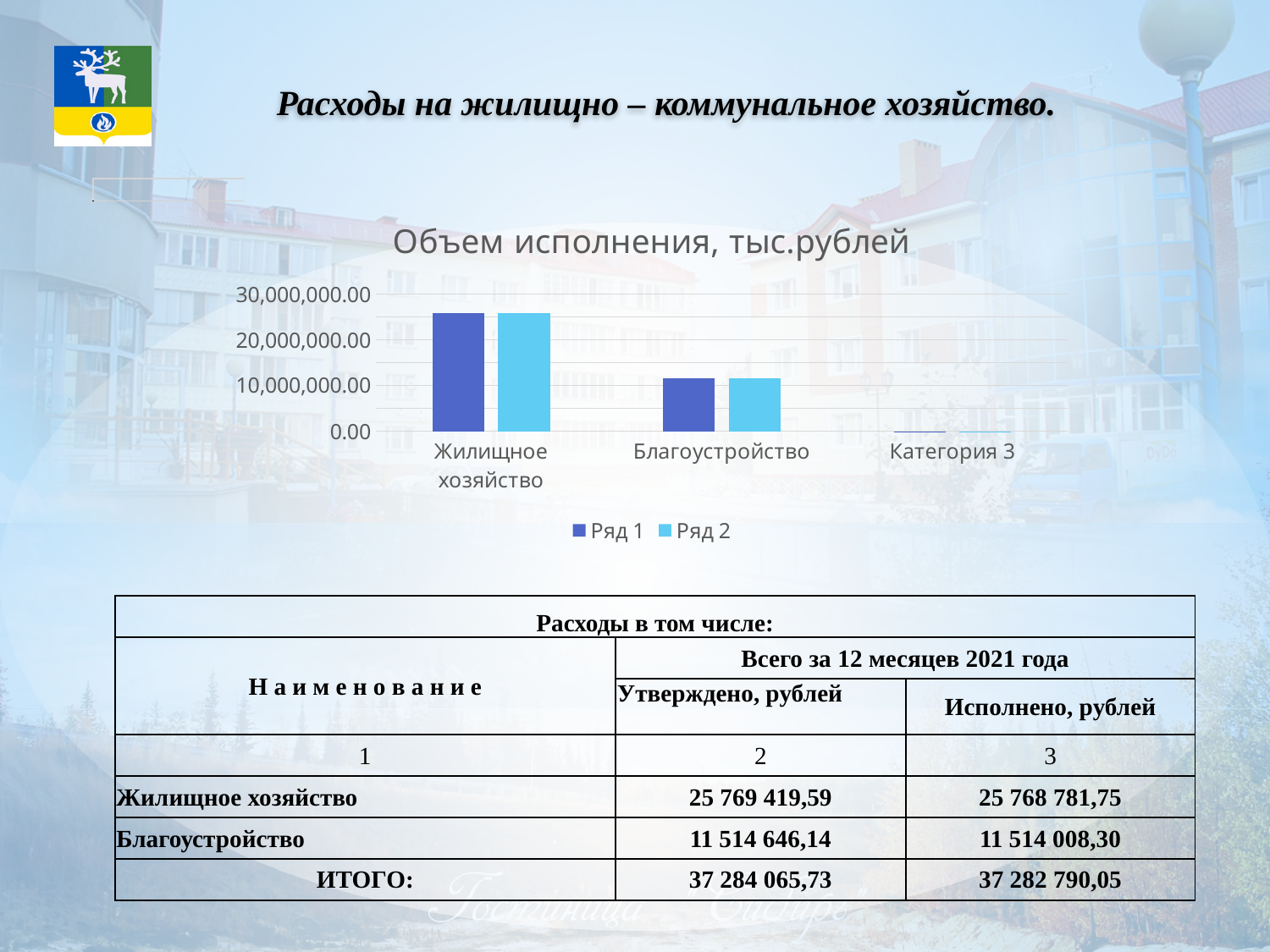
Which category has the lowest bars in the chart? Категория 3 How many categories are shown on the x axis of the chart? 3 Do the values in the chart rise or fall from left to right along the x axis? fall What kind of chart is shown on the slide? bar chart How many series does the chart legend list? 2 What is the title of the chart? Объем исполнения, тыс.рублей Is the Ряд 1 value for Жилищное хозяйство greater or less than 20,000,000.00? greater Which is larger in the chart: the Ряд 1 value for Жилищное хозяйство or the Ряд 1 value for Благоустройство? Жилищное хозяйство What are the two series names listed in the chart legend? Ряд 1 and Ряд 2 Which category has the highest bars in the chart? Жилищное хозяйство Is the Ряд 1 value for Благоустройство greater or less than 10,000,000.00? greater Is the Ряд 2 value for Благоустройство greater or less than 20,000,000.00? less